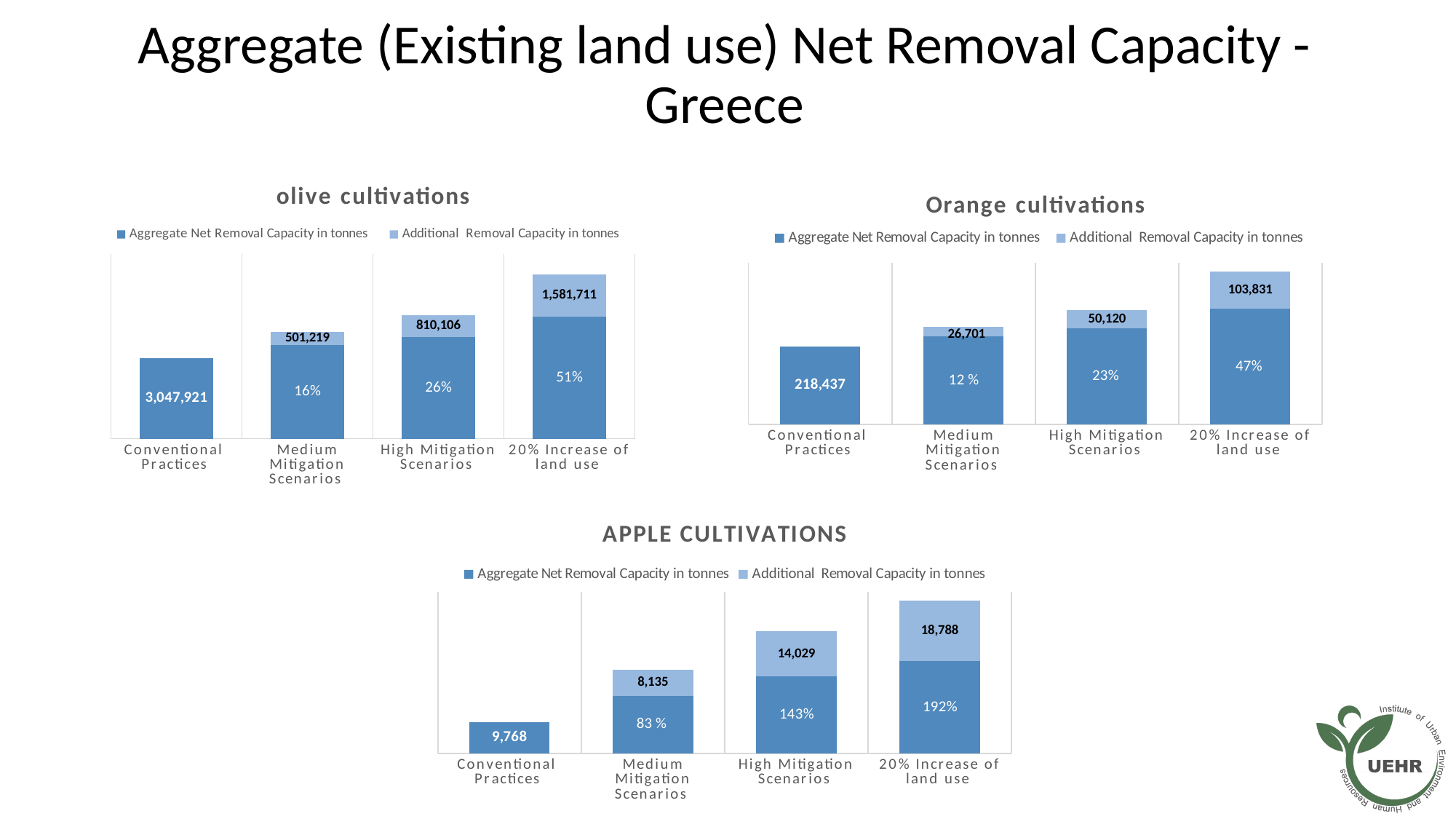
In the APPLE CULTIVATIONS chart, what is the Additional Removal Capacity in tonnes for Medium Mitigation Scenarios? 8,135 In the Orange cultivations chart, what is the Aggregate Net Removal Capacity in tonnes for Conventional Practices? 218,437 How many series does the legend of the Orange cultivations chart list? 2 In the Orange cultivations chart, what is the difference between the Additional Removal Capacity for 20% Increase of land use and for Medium Mitigation Scenarios? 77,130 In the olive cultivations chart, what is the Additional Removal Capacity in tonnes for the 20% Increase of land use scenario? 1,581,711 In the olive cultivations chart, what is the Aggregate Net Removal Capacity in tonnes for Conventional Practices? 3,047,921 In the olive cultivations chart, what percentage label is shown on the Aggregate Net Removal Capacity bar for High Mitigation Scenarios? 26% In the olive cultivations chart, is the Additional Removal Capacity larger for High Mitigation Scenarios or for Medium Mitigation Scenarios? High Mitigation Scenarios What type of chart is the APPLE CULTIVATIONS chart? Stacked bar chart In the APPLE CULTIVATIONS chart, what is the difference between the Additional Removal Capacity for 20% Increase of land use and for High Mitigation Scenarios? 4,759 In the APPLE CULTIVATIONS chart, which scenario has the highest Additional Removal Capacity? 20% Increase of land use In the Orange cultivations chart, what is the Additional Removal Capacity in tonnes for High Mitigation Scenarios? 50,120